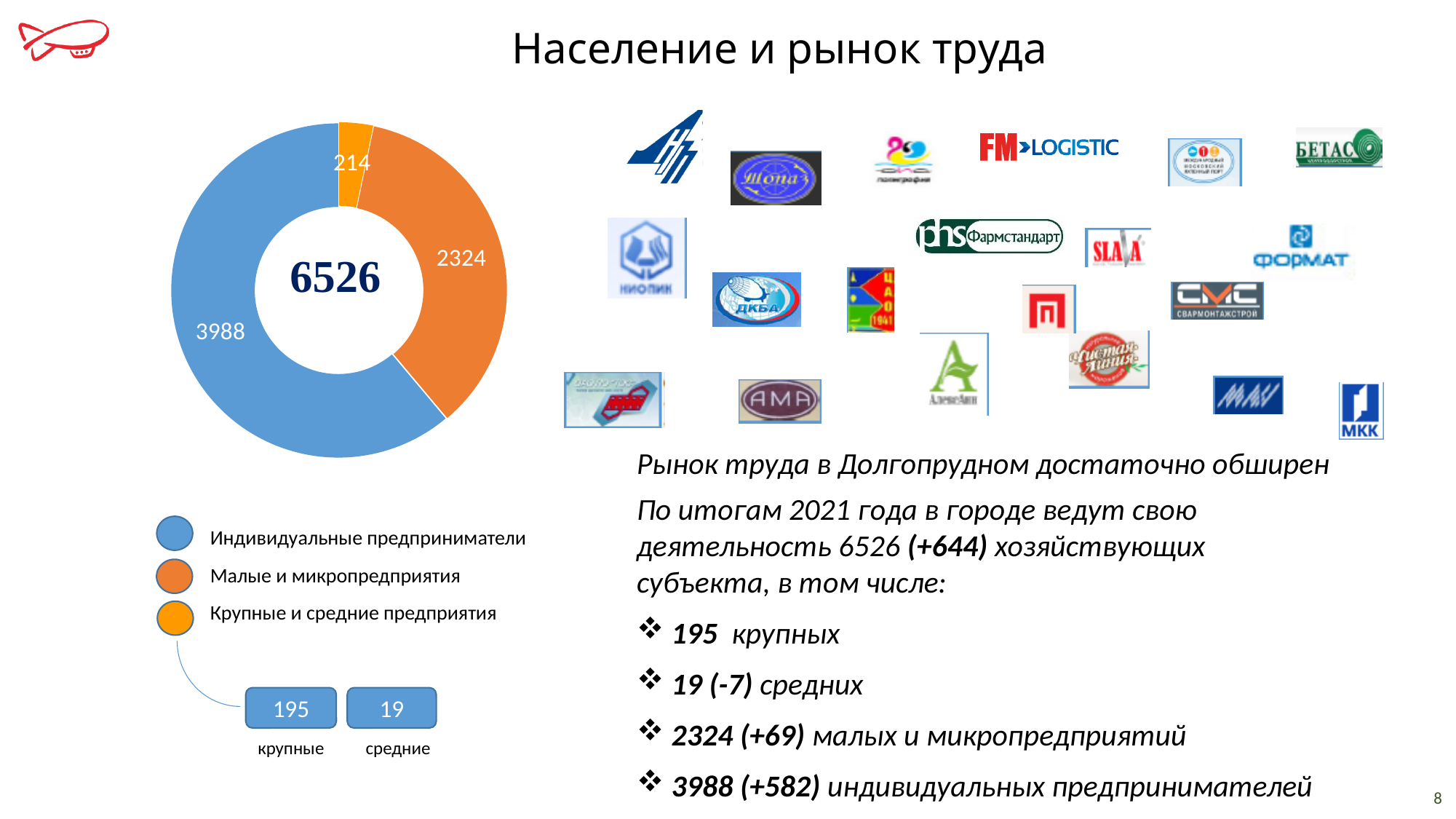
What colour represents 'Малые и микропредприятия' in the donut chart? Orange Which category has the largest segment in the donut chart? Индивидуальные предприниматели What is the difference between the values for 'Индивидуальные предприниматели' and 'Малые и микропредприятия' in the donut chart? 1664 Which category has the smallest segment in the donut chart? Крупные и средние предприятия Which is larger in the donut chart: 'Малые и микропредприятия' or 'Крупные и средние предприятия'? Малые и микропредприятия What value is shown for the segment 'Малые и микропредприятия' in the donut chart? 2324 How many categories does the legend of the donut chart list? 3 What is the difference between the values for 'Малые и микропредприятия' and 'Крупные и средние предприятия' in the donut chart? 2110 What type of chart is shown on the left of the slide? Donut (pie) chart What total is printed in the centre of the donut chart? 6526 What value is shown for the segment 'Индивидуальные предприниматели' in the donut chart? 3988 What value is shown for the segment 'Крупные и средние предприятия' in the donut chart? 214